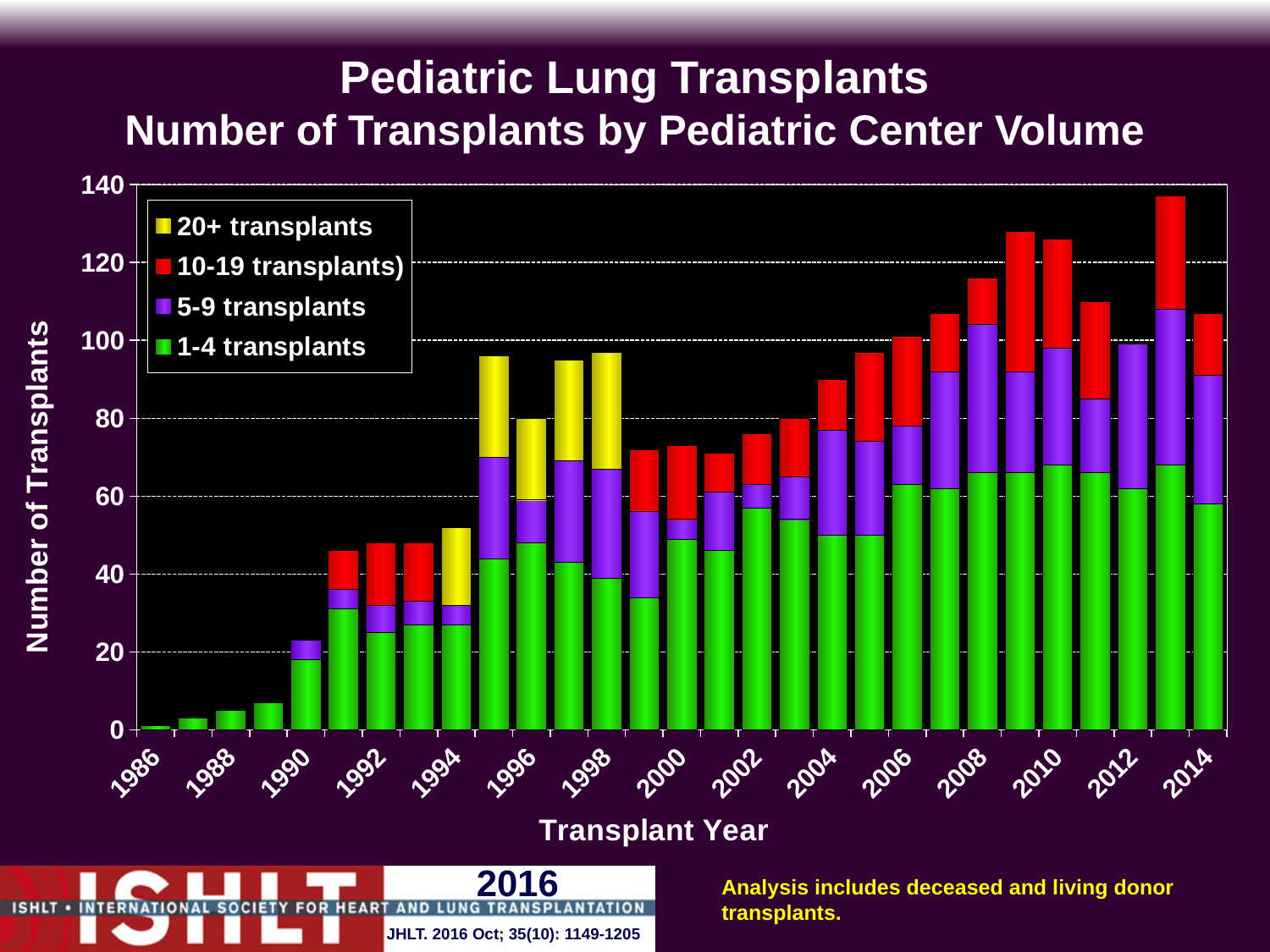
Which transplant year has the lowest total number of transplants? 1986 Which year has a larger total number of transplants, 1994 or 1995? 1995 What is the title of the x axis? Transplant Year Is the total number of transplants in 1986 greater or less than 20? less Which year has a larger total number of transplants, 2013 or 2014? 2013 Is the total number of transplants in 2000 greater or less than 80? less Which transplant year has the highest total number of transplants? 2013 What colour represents the '20+ transplants' series in the legend? Yellow How many series does the legend list? 4 What kind of chart is shown on the slide? Stacked bar chart Is the total number of transplants in 2013 greater or less than 120? greater Overall, does the total number of transplants rise or fall from 1986 to 2014? rise